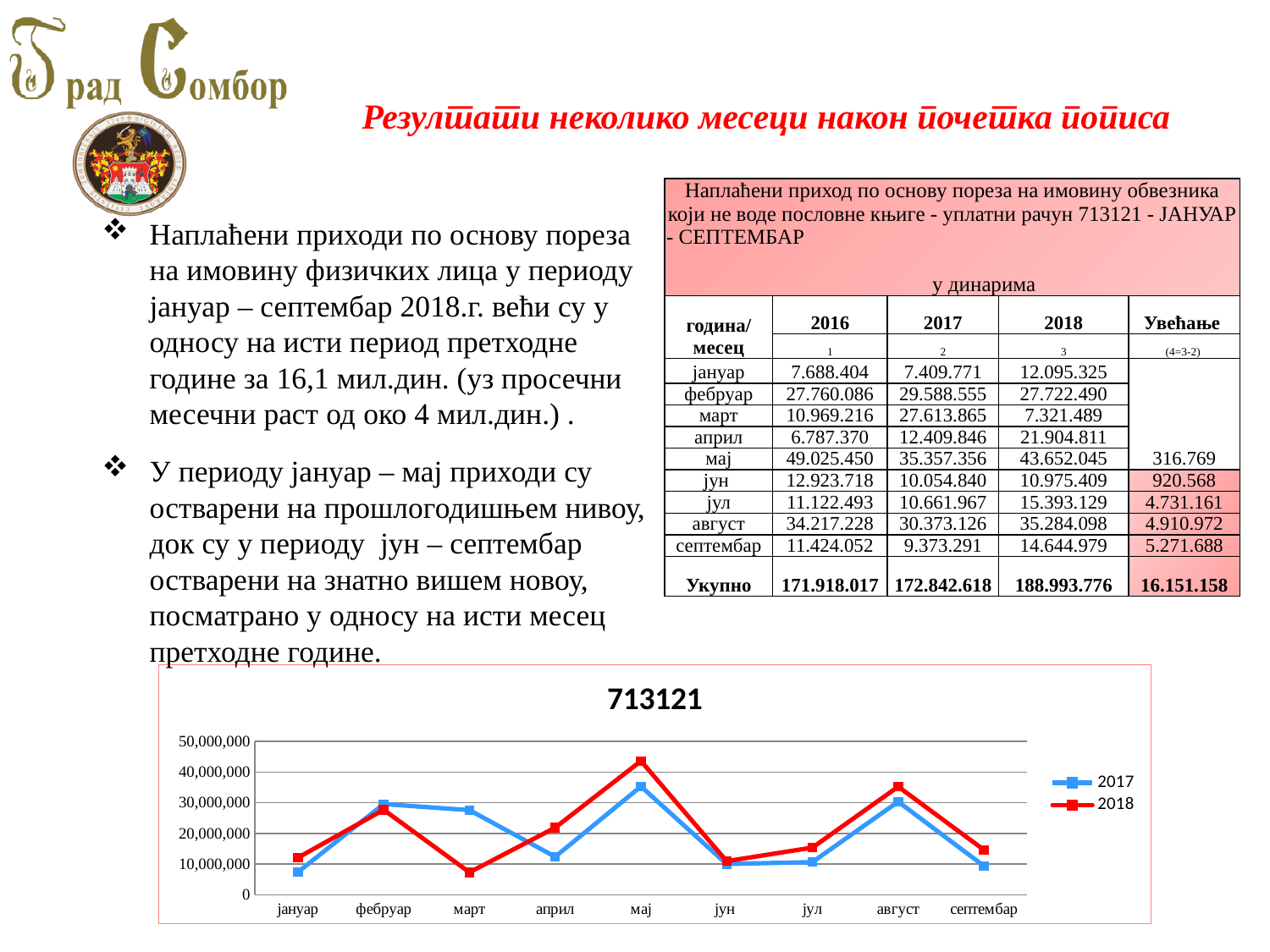
In which month does the 2018 series reach its highest value? мај Is the value for 2018 in март greater or less than 10,000,000? less What is the title of the chart? 713121 What kind of chart is shown on the slide? line chart In март, which series has the larger value, 2017 or 2018? 2017 How many series does the chart legend list? 2 How many months are plotted along the x axis of the chart? 9 Which colour is used for the 2018 series in the chart? red In април, which series has the larger value, 2017 or 2018? 2018 Is the value for 2018 in мај greater or less than 40,000,000? greater In which month does the 2017 series reach its highest value? мај In which month does the 2018 series reach its lowest value? март